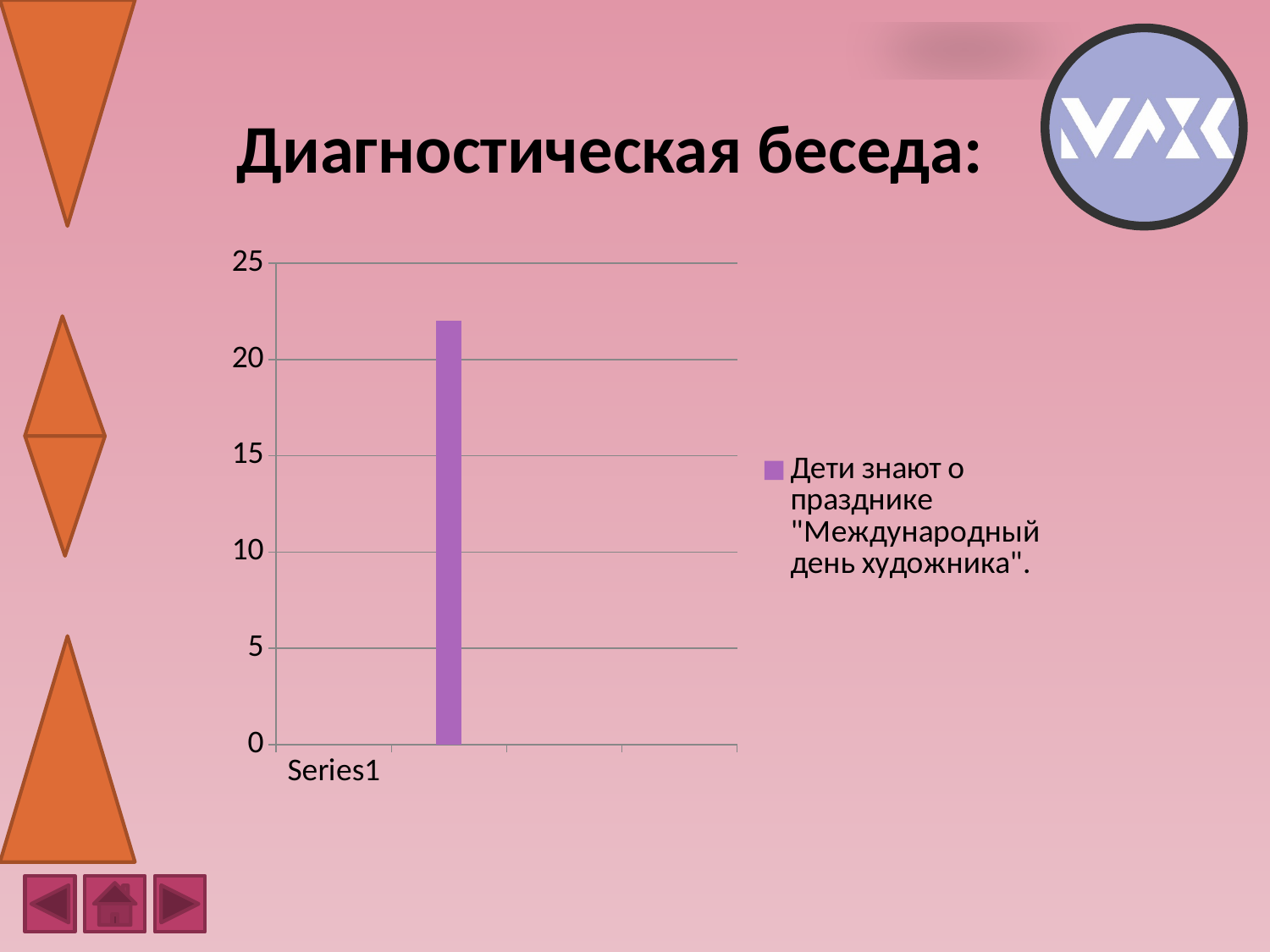
What is the highest value shown on the vertical axis of the chart? 25 How many bars are plotted in the chart? 1 Is the value of the bar for Series1 greater or less than 25? less How many series does the legend list? 1 What kind of chart is shown on the slide? bar chart What is the legend entry of the chart? Дети знают о празднике "Международный день художника". Is the value of the bar for Series1 greater or less than 20? greater What is the label shown under the x axis of the chart? Series1 Is the value of the bar for Series1 greater or less than 15? greater